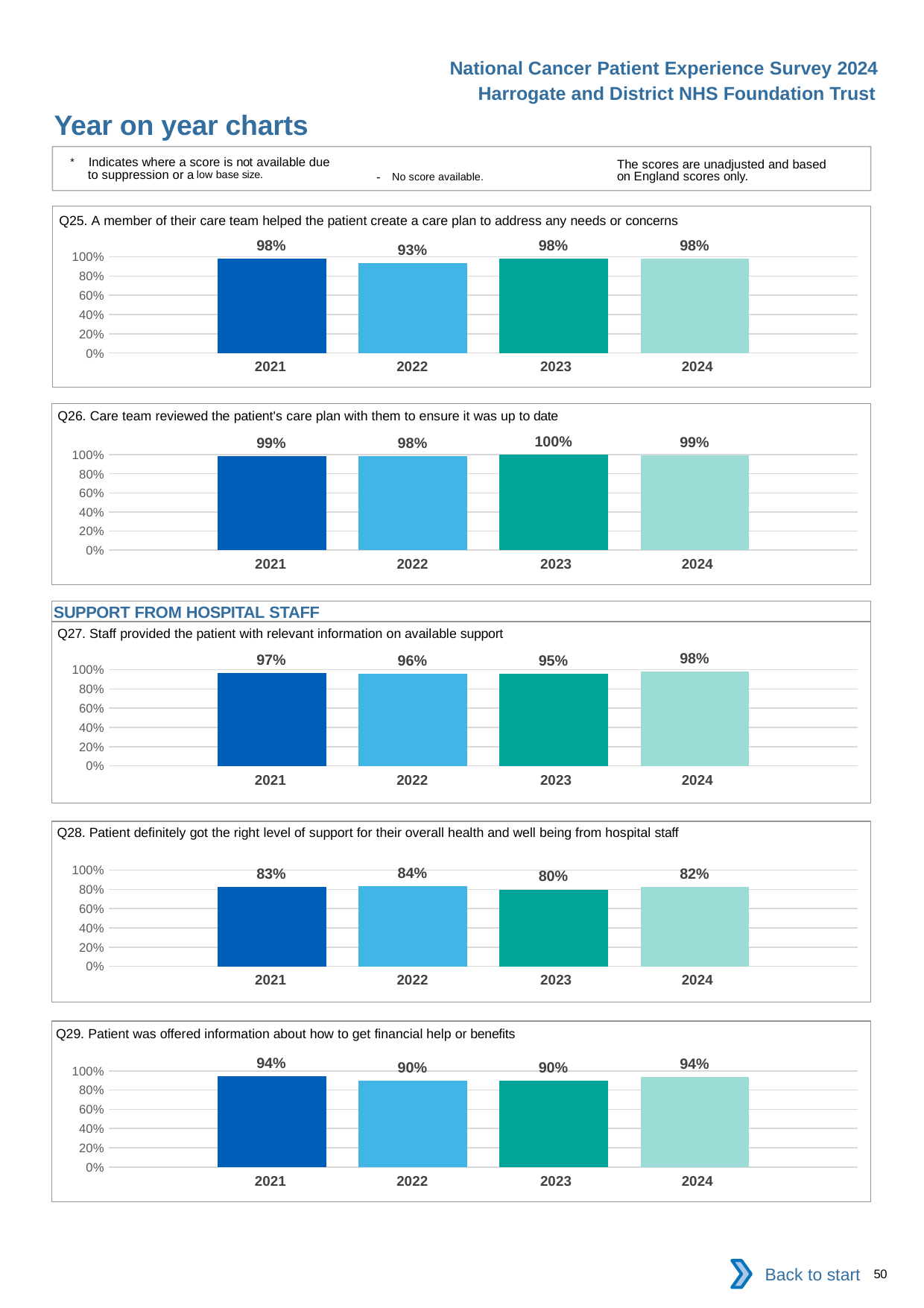
In the Q26 chart, which year has the highest value? 2023 In the Q28 chart, is the value for 2023 greater or less than 60%? greater What kind of chart is the Q27 chart? bar chart In the Q29 chart, what is the value for 2024? 94% How many years are shown in the Q29 chart? 4 In the Q27 chart, which year has the lowest value? 2023 In the Q25 chart, what is the value for 2022? 93% In the Q28 chart, what is the difference between the 2022 and 2023 values? 4% In the Q28 chart, which is larger, the value for 2021 or the value for 2024? 2021 In the Q27 chart, what is the difference between the 2024 and 2021 values? 1% What is the section heading shown above the Q27 chart? SUPPORT FROM HOSPITAL STAFF In the Q26 chart, what is the value for 2022? 98%